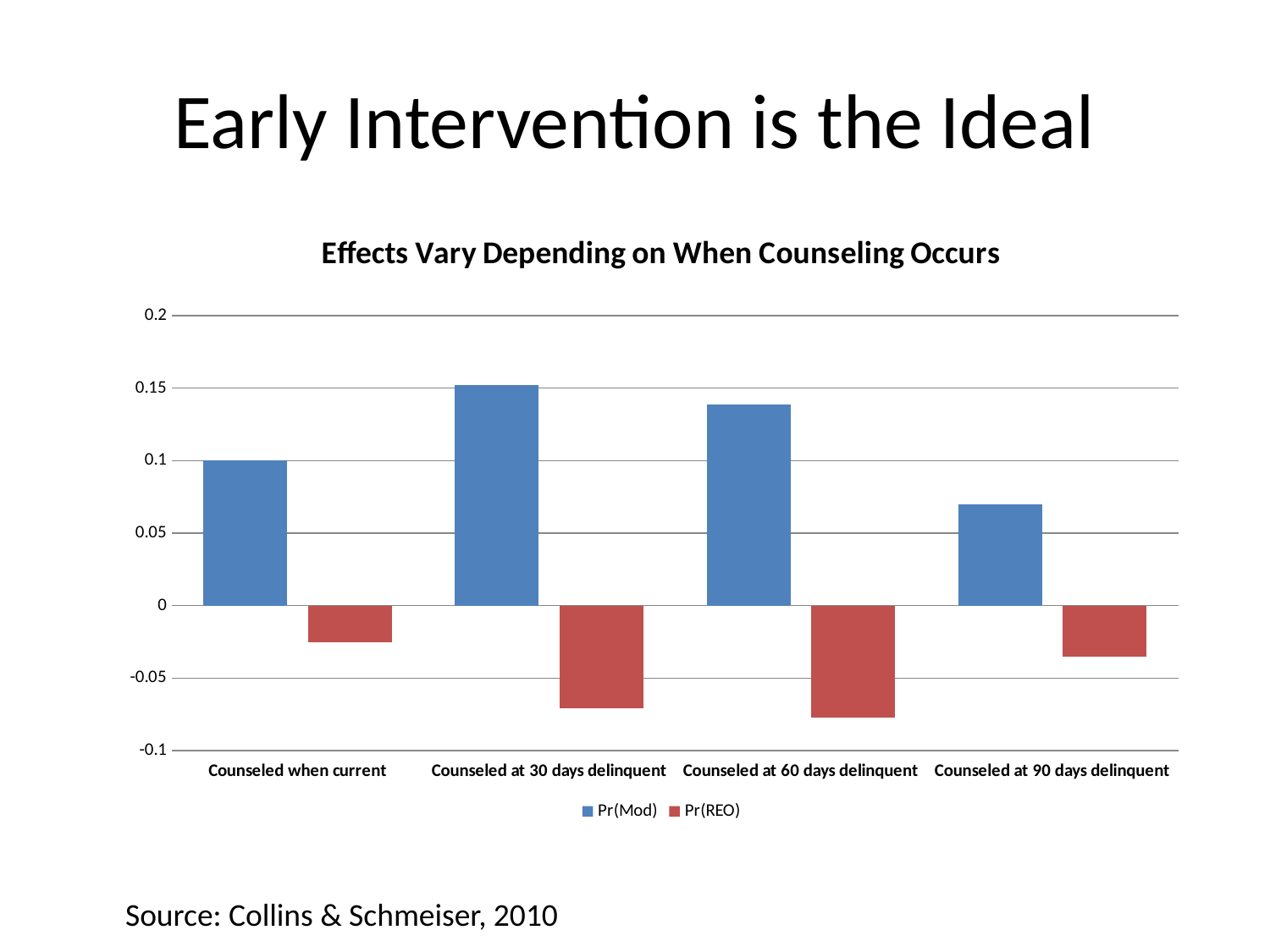
What is the title of the chart? Effects Vary Depending on When Counseling Occurs How many series does the legend list? 2 Which category has the lowest (most negative) Pr(REO) value? Counseled at 60 days delinquent What type of chart is shown on the slide? bar chart Which category has the lowest Pr(Mod) value? Counseled at 90 days delinquent Is the Pr(Mod) value for Counseled at 90 days delinquent greater or less than 0.05? greater How many categories are shown on the x axis? 4 Which series is shown in red in the legend? Pr(REO) Is the Pr(REO) value for Counseled at 60 days delinquent greater or less than -0.05? less Which is larger, the Pr(Mod) value for Counseled at 30 days delinquent or for Counseled at 60 days delinquent? Counseled at 30 days delinquent Is the Pr(Mod) value for Counseled at 60 days delinquent greater or less than 0.15? less Which category has the highest Pr(Mod) value? Counseled at 30 days delinquent